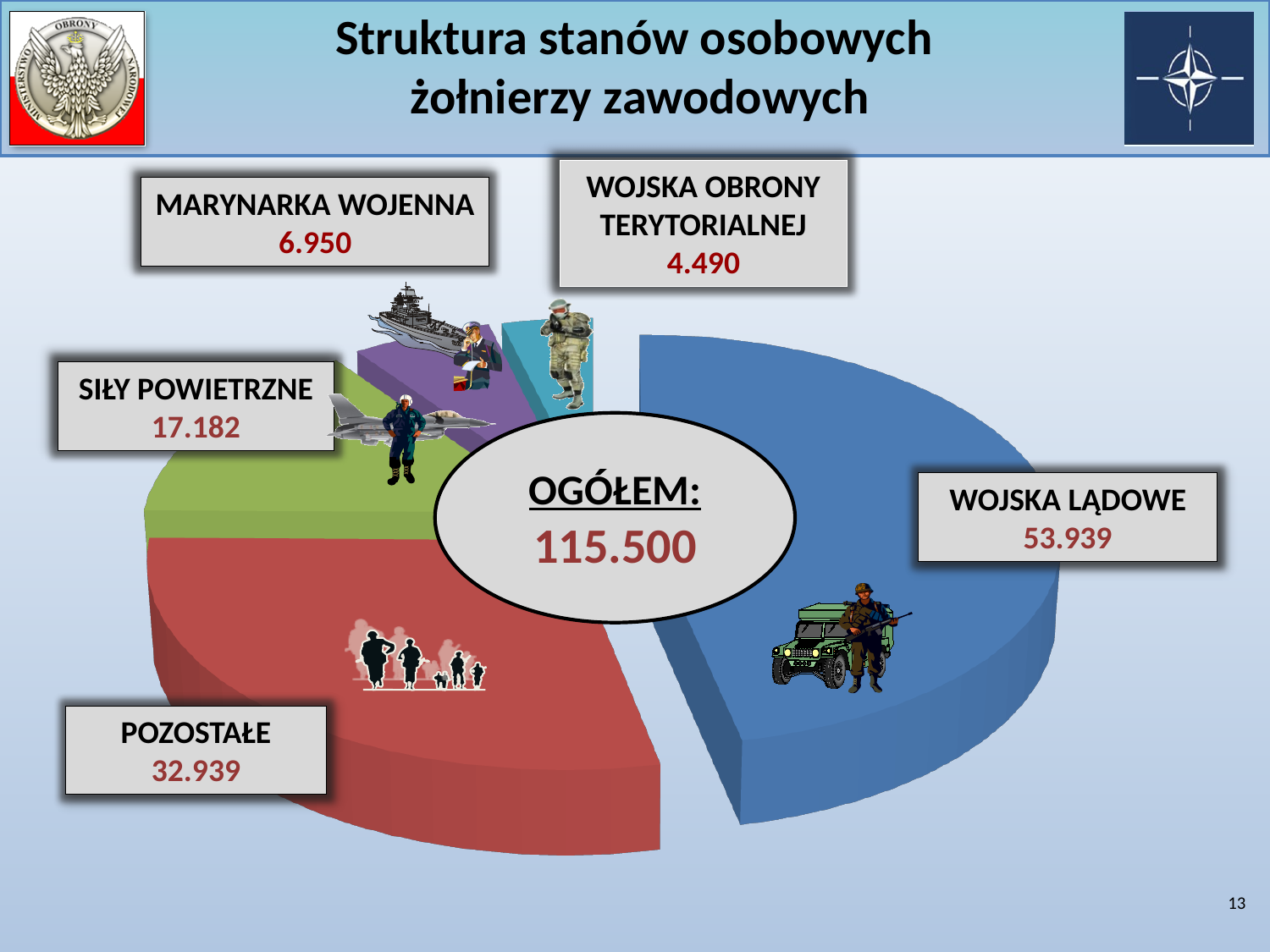
How many categories are shown in the pie chart? 5 What is the value shown for Siły Powietrzne? 17.182 What is the value shown for Wojska Lądowe? 53.939 What is the difference between the values for Wojska Lądowe and Pozostałe? 21.000 Which is larger, Siły Powietrzne or Marynarka Wojenna? Siły Powietrzne What total (OGÓŁEM) is shown in the centre of the chart? 115.500 What is the difference between the values for Marynarka Wojenna and Wojska Obrony Terytorialnej? 2.460 Which category has the smallest slice of the pie? Wojska Obrony Terytorialnej What kind of chart is shown on the slide? Pie chart What is the value shown for Wojska Obrony Terytorialnej? 4.490 Which category has the largest slice of the pie? Wojska Lądowe What is the value shown for Marynarka Wojenna? 6.950